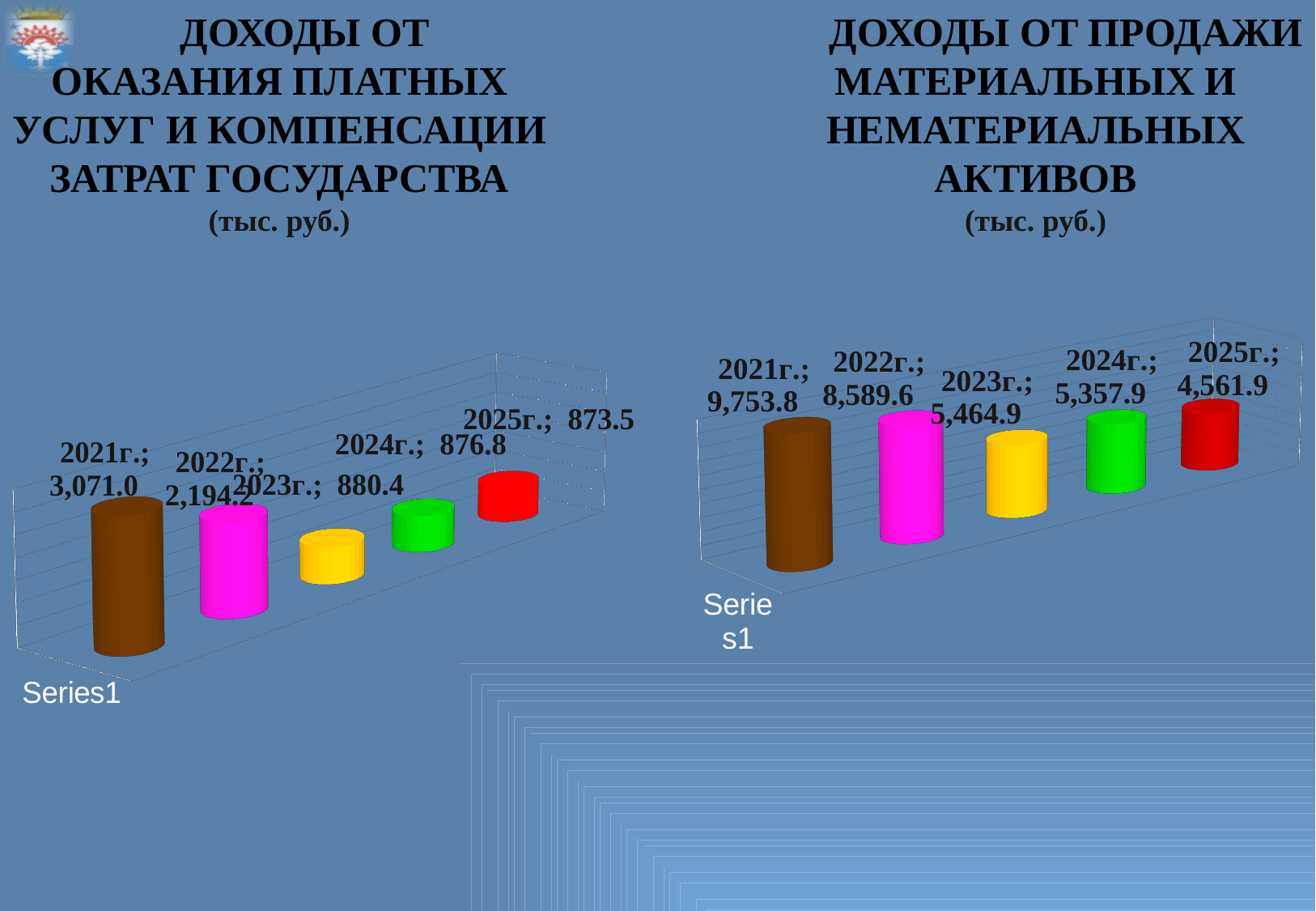
In the left chart (ДОХОДЫ ОТ ОКАЗАНИЯ ПЛАТНЫХ УСЛУГ И КОМПЕНСАЦИИ ЗАТРАТ ГОСУДАРСТВА), which year has the highest value? 2021г. In the left chart (ДОХОДЫ ОТ ОКАЗАНИЯ ПЛАТНЫХ УСЛУГ И КОМПЕНСАЦИИ ЗАТРАТ ГОСУДАРСТВА), what is the value for 2021г.? 3,071.0 In the right chart (ДОХОДЫ ОТ ПРОДАЖИ МАТЕРИАЛЬНЫХ И НЕМАТЕРИАЛЬНЫХ АКТИВОВ), do the values rise or fall from 2021г. to 2025г.? Fall In the right chart (ДОХОДЫ ОТ ПРОДАЖИ МАТЕРИАЛЬНЫХ И НЕМАТЕРИАЛЬНЫХ АКТИВОВ), which year has the lowest value? 2025г. In the right chart (ДОХОДЫ ОТ ПРОДАЖИ МАТЕРИАЛЬНЫХ И НЕМАТЕРИАЛЬНЫХ АКТИВОВ), what is the value for 2025г.? 4,561.9 What kind of chart is the right chart (ДОХОДЫ ОТ ПРОДАЖИ МАТЕРИАЛЬНЫХ И НЕМАТЕРИАЛЬНЫХ АКТИВОВ)? Bar chart In the left chart (ДОХОДЫ ОТ ОКАЗАНИЯ ПЛАТНЫХ УСЛУГ И КОМПЕНСАЦИИ ЗАТРАТ ГОСУДАРСТВА), what is the value for 2024г.? 876.8 In the right chart (ДОХОДЫ ОТ ПРОДАЖИ МАТЕРИАЛЬНЫХ И НЕМАТЕРИАЛЬНЫХ АКТИВОВ), what is the value for 2023г.? 5,464.9 In the left chart (ДОХОДЫ ОТ ОКАЗАНИЯ ПЛАТНЫХ УСЛУГ И КОМПЕНСАЦИИ ЗАТРАТ ГОСУДАРСТВА), what is the difference between the values for 2021г. and 2022г.? 876.8 In the right chart (ДОХОДЫ ОТ ПРОДАЖИ МАТЕРИАЛЬНЫХ И НЕМАТЕРИАЛЬНЫХ АКТИВОВ), which is larger, the value for 2022г. or the value for 2023г.? 2022г. In the right chart (ДОХОДЫ ОТ ПРОДАЖИ МАТЕРИАЛЬНЫХ И НЕМАТЕРИАЛЬНЫХ АКТИВОВ), what is the difference between the values for 2021г. and 2025г.? 5,191.9 How many years are shown in the left chart (ДОХОДЫ ОТ ОКАЗАНИЯ ПЛАТНЫХ УСЛУГ И КОМПЕНСАЦИИ ЗАТРАТ ГОСУДАРСТВА)? 5